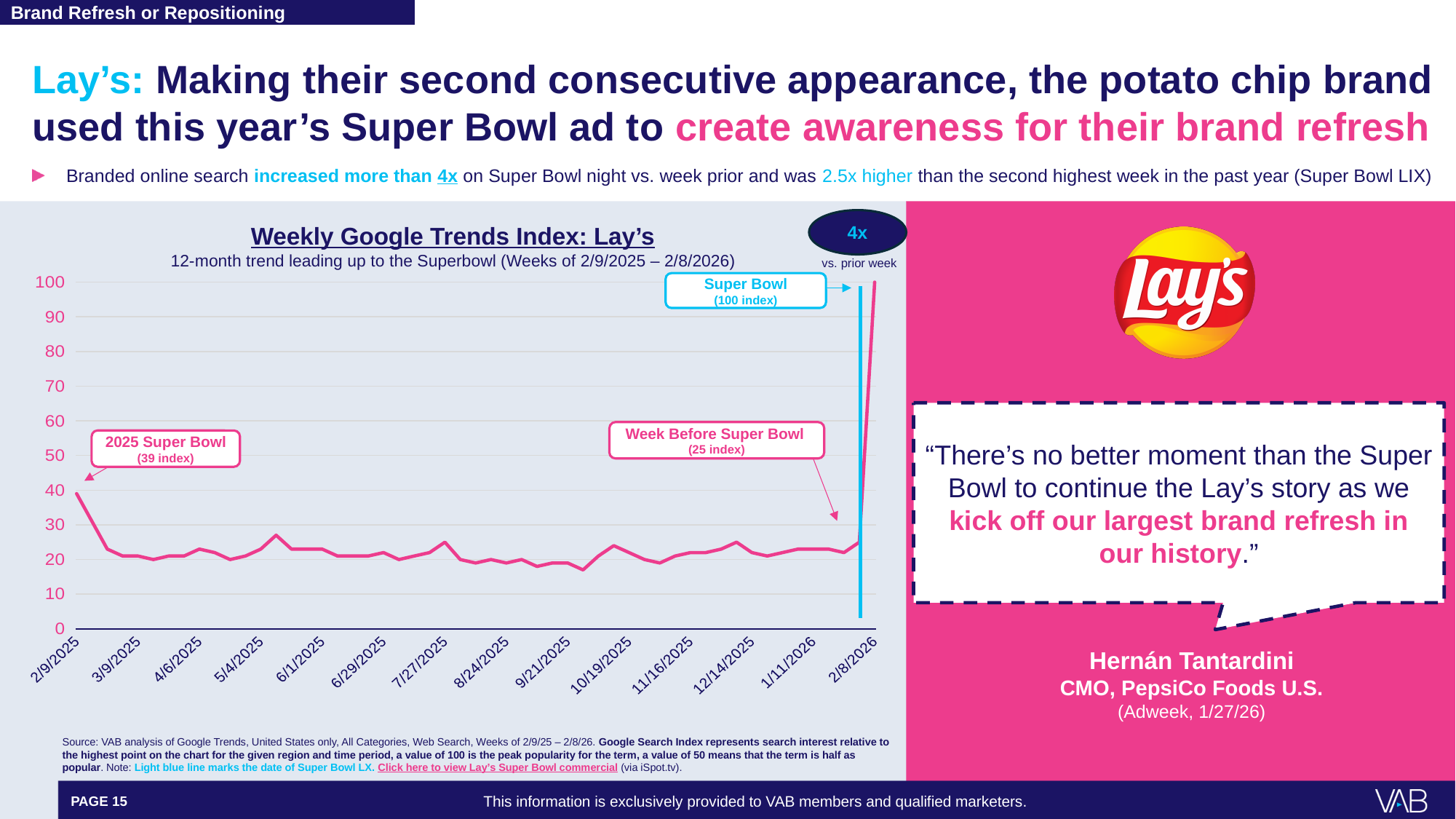
According to the chart note, what does the light blue vertical line mark? The date of Super Bowl LX What index value is labeled for the week before the Super Bowl on the chart? 25 What kind of chart is the Weekly Google Trends Index: Lay's chart? line chart Does the index rise or fall between the week of 2/9/2025 and the week of 3/9/2025? fall What is the difference between the 2025 Super Bowl index and the week before the 2026 Super Bowl index? 14 What index value is labeled for the 2025 Super Bowl week (2/9/2025) on the chart? 39 What is the Google Trends index value for the Super Bowl week (2/8/2026) on the Weekly Google Trends Index: Lay's chart? 100 Is the index value for the week of 6/1/2025 greater or less than 30? less What is the difference between the Super Bowl week index (100) and the week before Super Bowl index (25)? 75 How many date labels are shown on the x axis of the chart? 14 Which week has the highest Google Trends index on the chart? Super Bowl week (2/8/2026) Which is larger: the index for the 2025 Super Bowl week or the index for the week before the 2026 Super Bowl? 2025 Super Bowl week